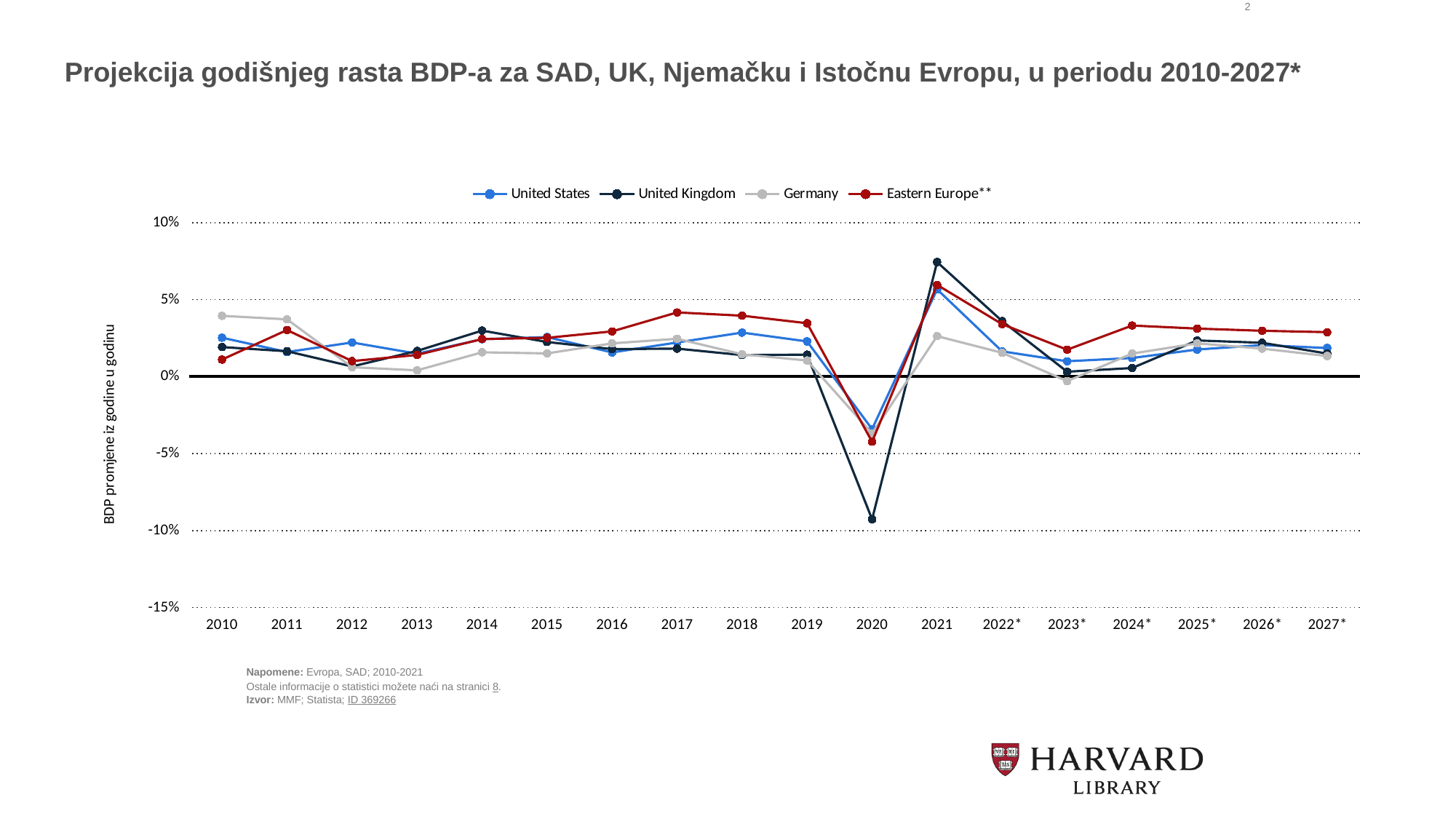
Did the United States value rise or fall from 2019 to 2020? fall How many series does the legend list? 4 Which series has the highest value in 2021? United Kingdom Which series has the highest value in 2024*? Eastern Europe Which series has the lowest value in 2020? United Kingdom What is the label of the y axis? BDP promjene iz godine u godinu How many years are shown on the x axis? 18 What kind of chart is shown on the slide? line chart In 2010, which is higher: Germany or United States? Germany Is the value for United Kingdom in 2020 greater or less than -5%? less Is the value for United Kingdom in 2021 greater or less than 5%? greater Is the value for Eastern Europe in 2020 greater or less than 0%? less